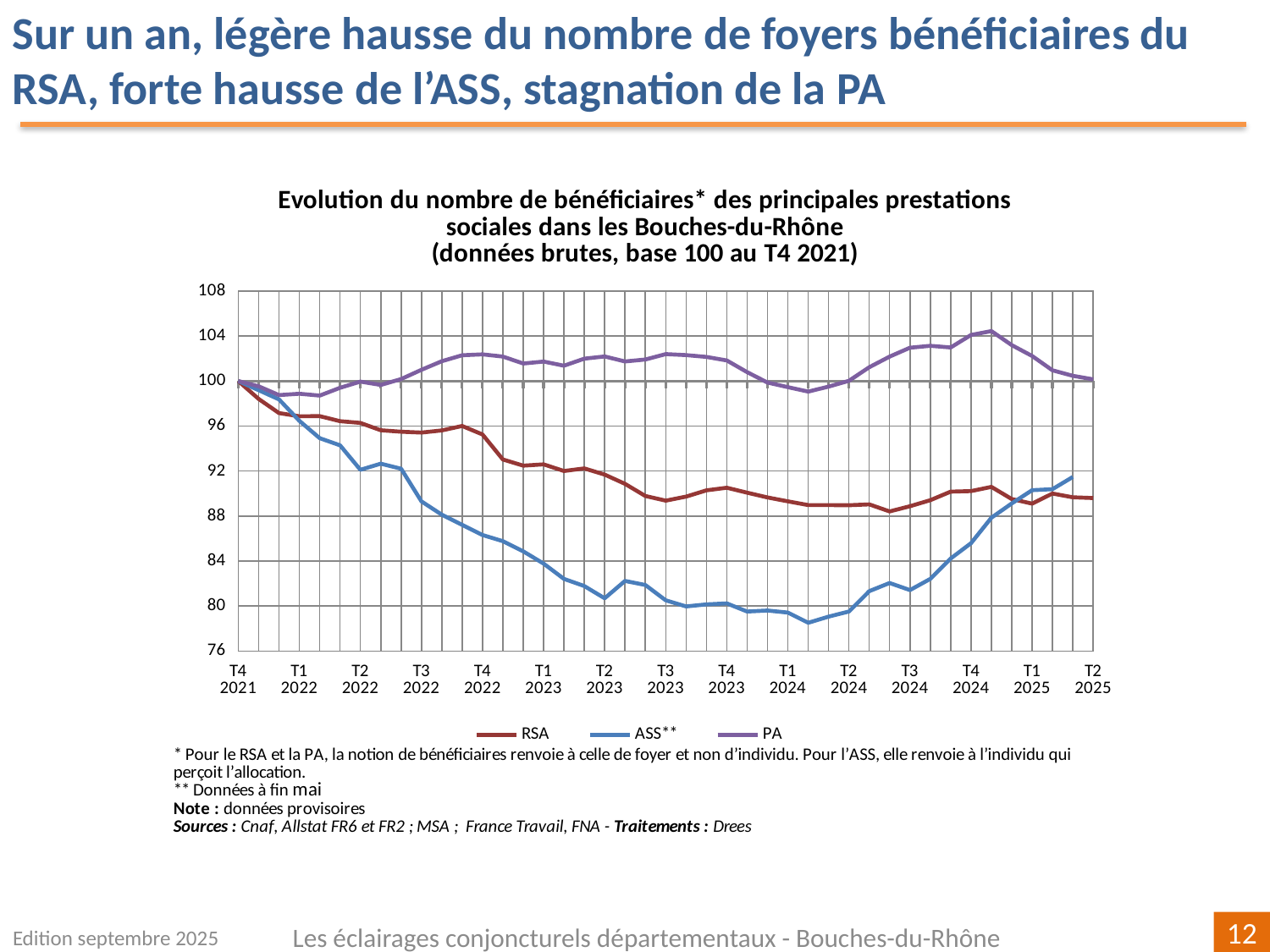
Which series is drawn in purple? PA Which series has the highest value at T2 2025? PA Is the value for PA at T3 2024 greater or less than 100? greater How many series does the legend list? 3 Which series has the lowest value at T1 2024? ASS** What kind of chart is shown on the slide? line chart Is the value for ASS** at T1 2024 greater or less than 80? less How many quarters are labelled on the x axis? 15 Does the ASS** series rise or fall between T4 2021 and T1 2024? fall Is the value for RSA at T2 2025 greater or less than 92? less What is the value of the RSA series at T4 2021? 100